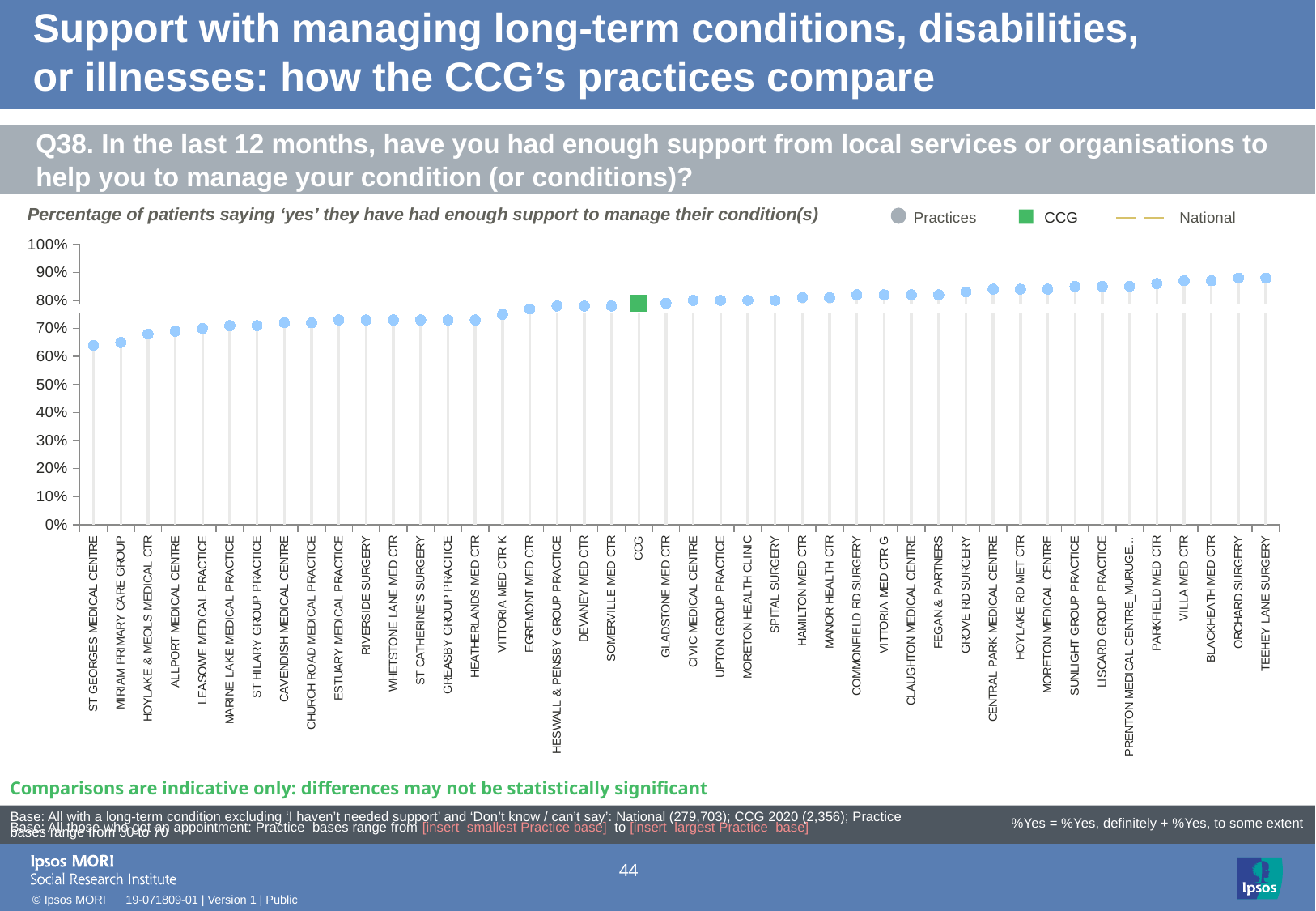
Is the value for ORCHARD SURGERY greater or less than 80%? greater Do the values rise or fall moving from left to right along the x axis? rise Is the value for CCG greater or less than 70%? greater Which has the higher value, ST GEORGES MEDICAL CENTRE or TEEHEY LANE SURGERY? TEEHEY LANE SURGERY Which category is shown with a green square marker instead of a blue dot? CCG How many series does the legend list? 3 Is the value for ST GEORGES MEDICAL CENTRE greater or less than 70%? less What are the three entries in the chart legend? Practices, CCG, National What kind of chart is shown on the slide? Dot (lollipop) chart